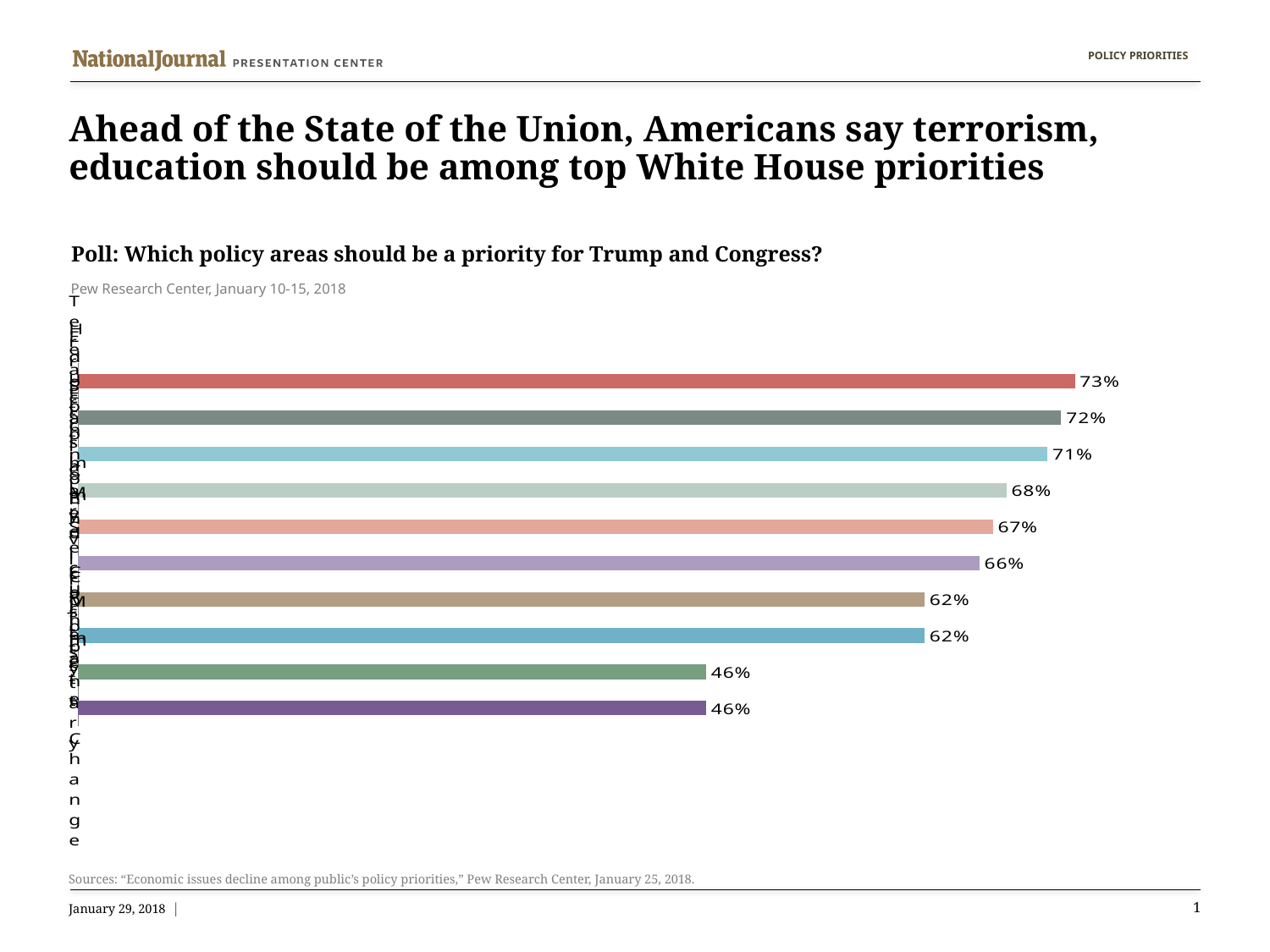
What is the value shown on the top (first) bar of the chart? 73% Do the bar values increase or decrease going from the top of the chart to the bottom? decrease How many bars are plotted in the chart? 10 How many bars in the chart show a value of 62%? 2 What is the lowest value shown in the chart? 46% What is the difference between the top bar's value and the bottom bar's value? 27 percentage points What kind of chart is shown on the slide? bar chart What is the value shown on the sixth bar from the top (the lavender bar)? 66% What is the highest value shown in the chart? 73% What is the value shown on the third bar from the top? 71% Which is larger, the value of the second bar from the top or the value of the fourth bar from the top? the second bar (72%) What is the value shown on the bottom (last) bar of the chart? 46%